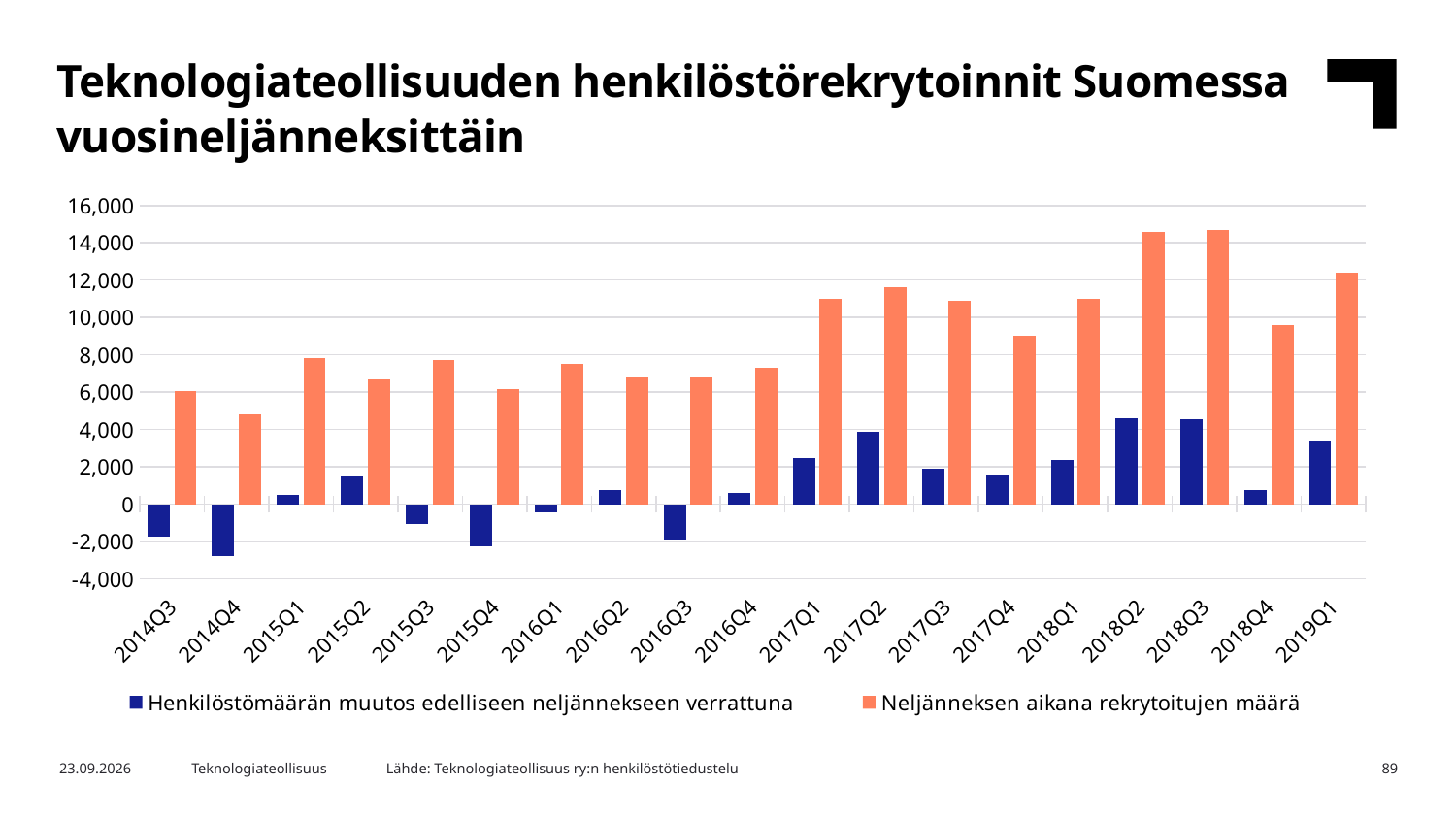
How many quarters are shown on the x axis? 19 Is the value for Henkilöstömäärän muutos edelliseen neljännekseen verrattuna in 2016Q3 greater or less than 0? less Is the value for Neljänneksen aikana rekrytoitujen määrä in 2019Q1 greater or less than 12,000? greater Which quarter has the lowest value for Henkilöstömäärän muutos edelliseen neljännekseen verrattuna? 2014Q4 Is the value for Henkilöstömäärän muutos edelliseen neljännekseen verrattuna in 2017Q2 greater or less than 2,000? greater What type of chart is shown on the slide? bar chart How many series does the legend list? 2 What colour are the bars for Neljänneksen aikana rekrytoitujen määrä? orange Which is larger for Neljänneksen aikana rekrytoitujen määrä: 2014Q4 or 2015Q1? 2015Q1 Which quarter has the lowest value for Neljänneksen aikana rekrytoitujen määrä? 2014Q4 Which is larger for Neljänneksen aikana rekrytoitujen määrä: 2017Q2 or 2017Q3? 2017Q2